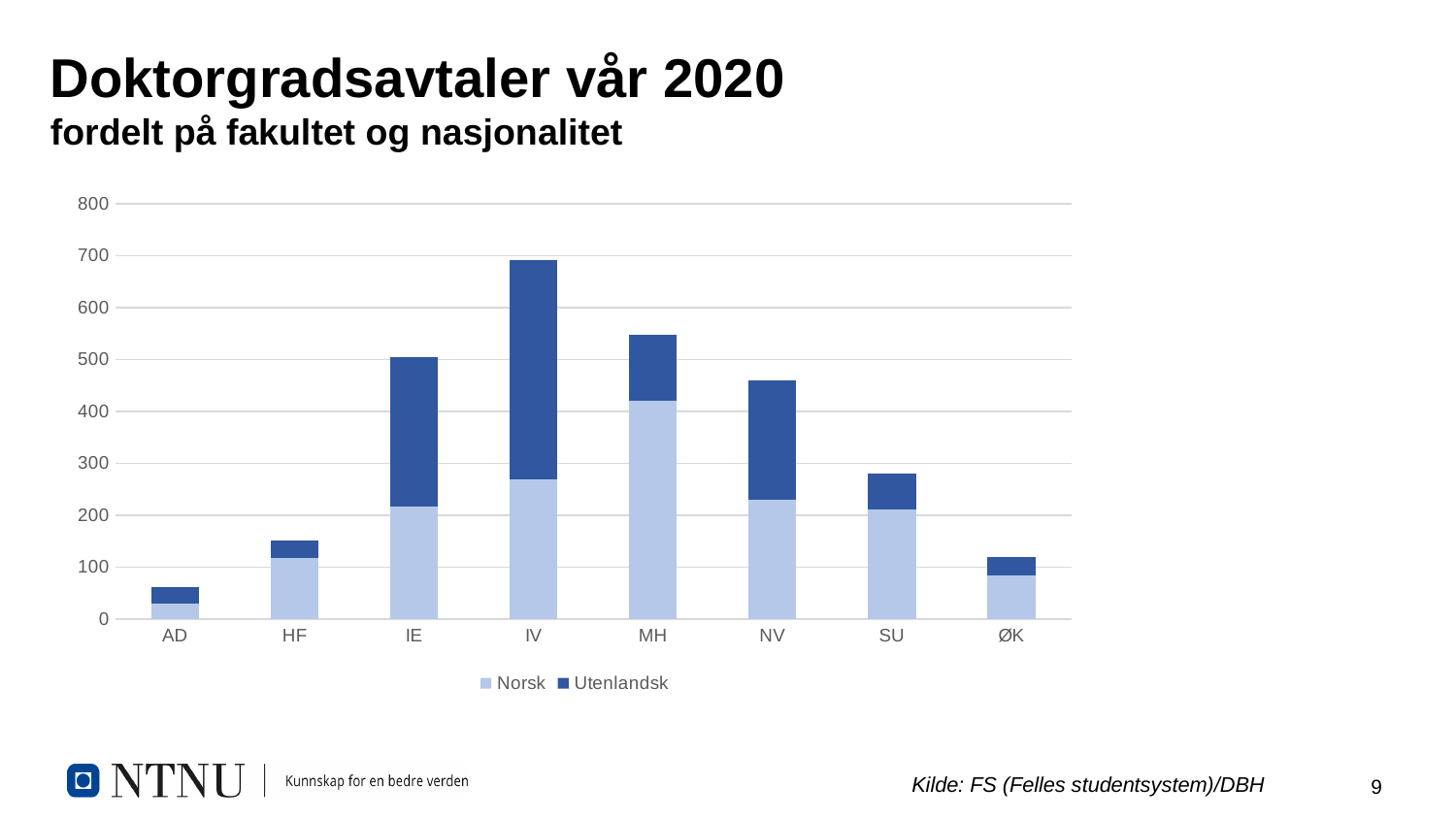
What are the two series named in the legend? Norsk and Utenlandsk Which faculty has the shortest stacked bar (lowest total)? AD What kind of chart is shown on the slide? Stacked bar chart Which faculty has the tallest stacked bar (highest total)? IV Which faculty has the larger Norsk value, MH or IV? MH Is the total value for IV greater or less than 600? greater Which faculty has the larger total, IV or MH? IV Is the total value for AD greater or less than 100? less Is the Norsk value for MH greater or less than 400? greater What is the title of the chart on the slide? Doktorgradsavtaler vår 2020 How many series does the legend list? 2 How many faculties (categories) are shown on the x axis? 8